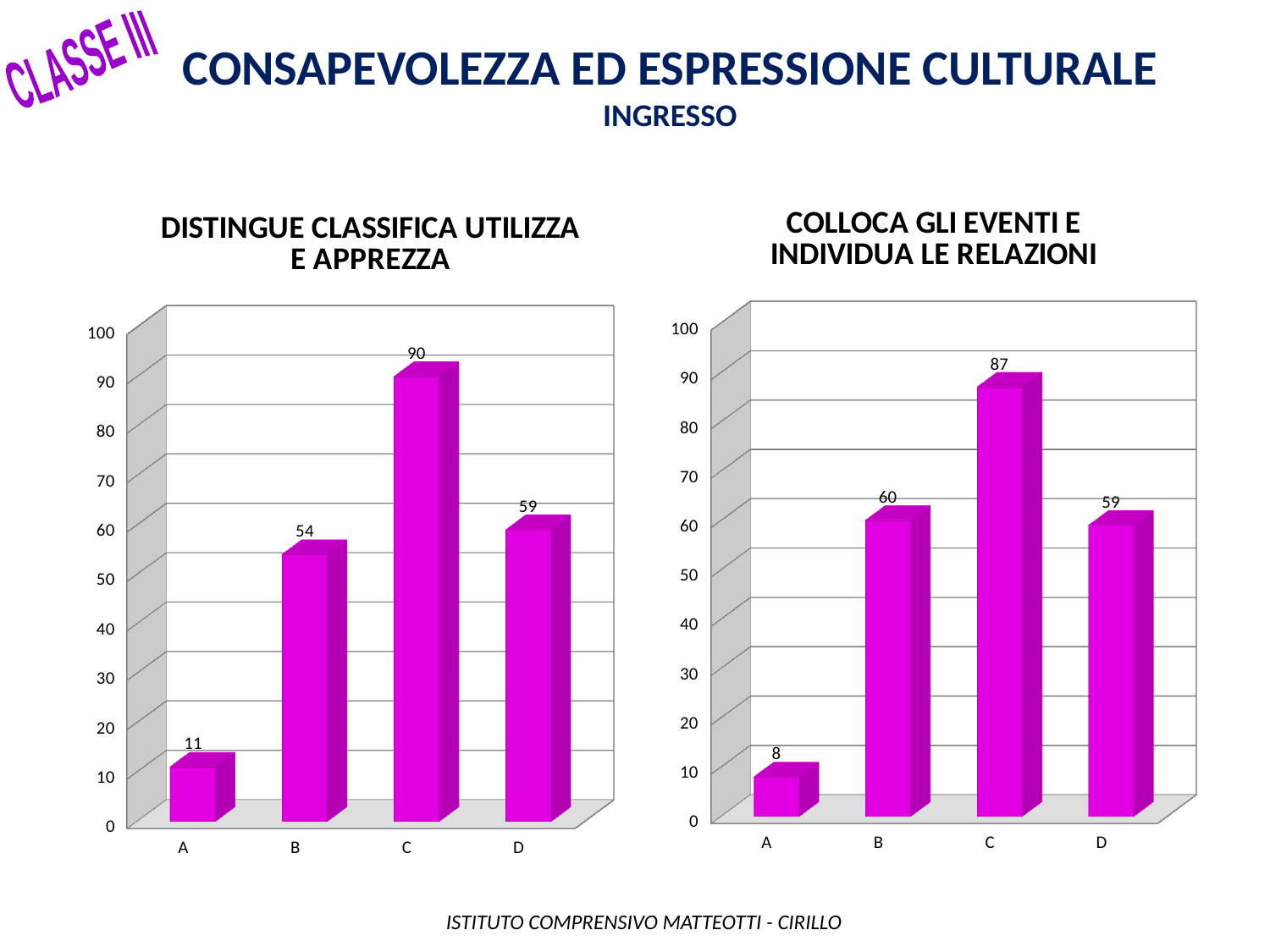
What is the title of the chart on the left of the slide? DISTINGUE CLASSIFICA UTILIZZA E APPREZZA In the 'COLLOCA GLI EVENTI E INDIVIDUA LE RELAZIONI' chart, what is the difference between the values for C and D? 28 In the 'DISTINGUE CLASSIFICA UTILIZZA E APPREZZA' chart, which is larger, the value for B or the value for D? D In the 'COLLOCA GLI EVENTI E INDIVIDUA LE RELAZIONI' chart, what is the value for category D? 59 In the 'DISTINGUE CLASSIFICA UTILIZZA E APPREZZA' chart, which category has the lowest value? A In the 'DISTINGUE CLASSIFICA UTILIZZA E APPREZZA' chart, what is the difference between the values for C and B? 36 How many categories are shown in the 'DISTINGUE CLASSIFICA UTILIZZA E APPREZZA' chart? 4 What kind of chart is the 'COLLOCA GLI EVENTI E INDIVIDUA LE RELAZIONI' chart? Bar chart In the 'COLLOCA GLI EVENTI E INDIVIDUA LE RELAZIONI' chart, is the value for B greater or less than 50? greater In the 'COLLOCA GLI EVENTI E INDIVIDUA LE RELAZIONI' chart, which category has the highest value? C In the 'COLLOCA GLI EVENTI E INDIVIDUA LE RELAZIONI' chart, what is the value for category A? 8 In the 'DISTINGUE CLASSIFICA UTILIZZA E APPREZZA' chart, what is the value for category C? 90